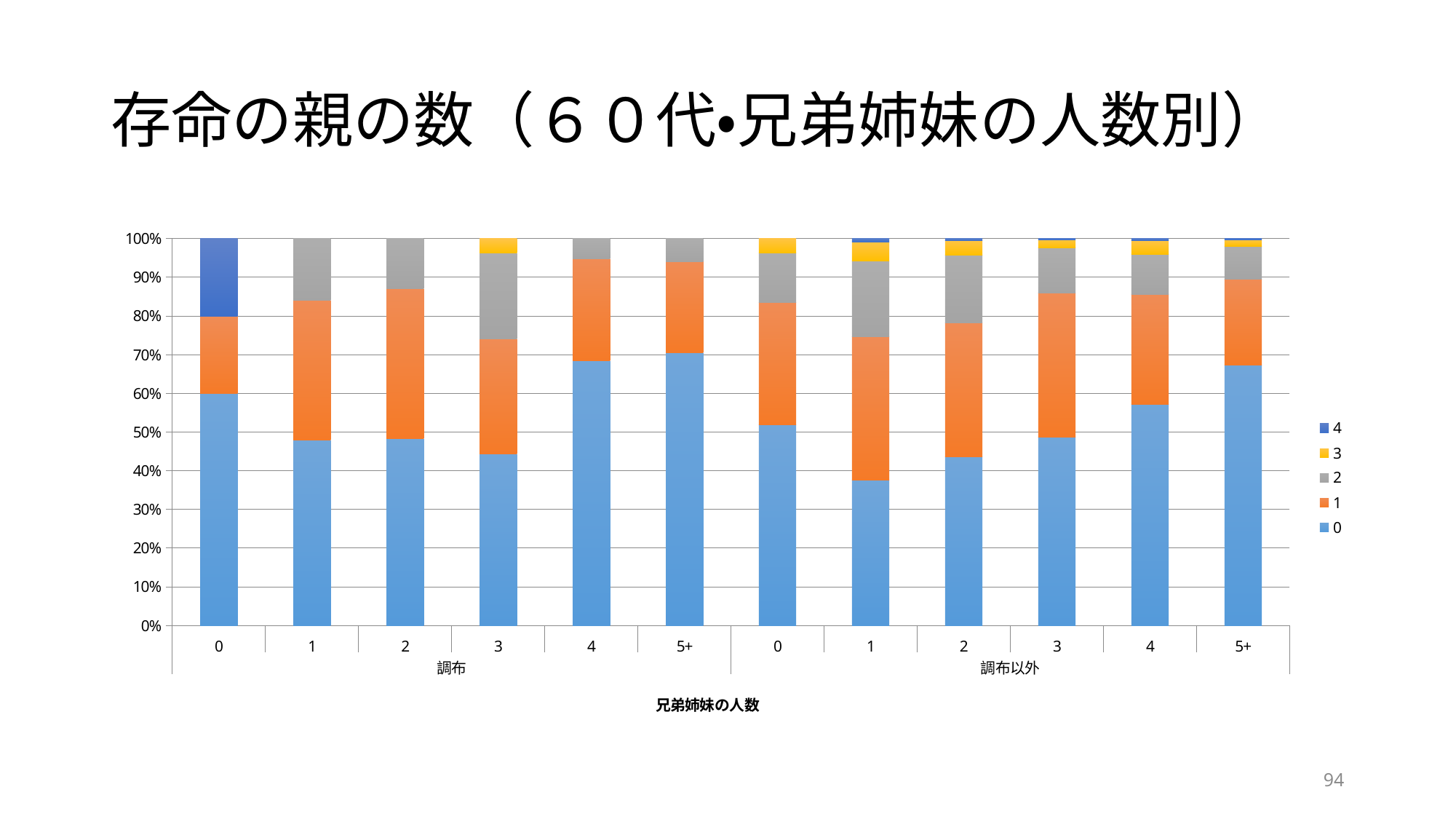
Is the share of series 0 for the 調布 3 bar greater or less than 50%? less Which has the larger share of series 0: the 調布 0 bar or the 調布 1 bar? 調布 0 Is the share of series 0 for the 調布 0 bar greater or less than 50%? greater Is the share of series 0 for the 調布以外 1 bar greater or less than 40%? less What does each stacked bar total on the vertical axis? 100% How many series does the legend list? 5 Which bar has the smallest share of series 0? 調布以外 1 How many stacked bars are plotted in the chart? 12 What is the title of the chart's horizontal axis? 兄弟姉妹の人数 What kind of chart is shown on the slide? Stacked bar chart What are the two groups into which the categories on the x axis are divided? 調布 and 調布以外